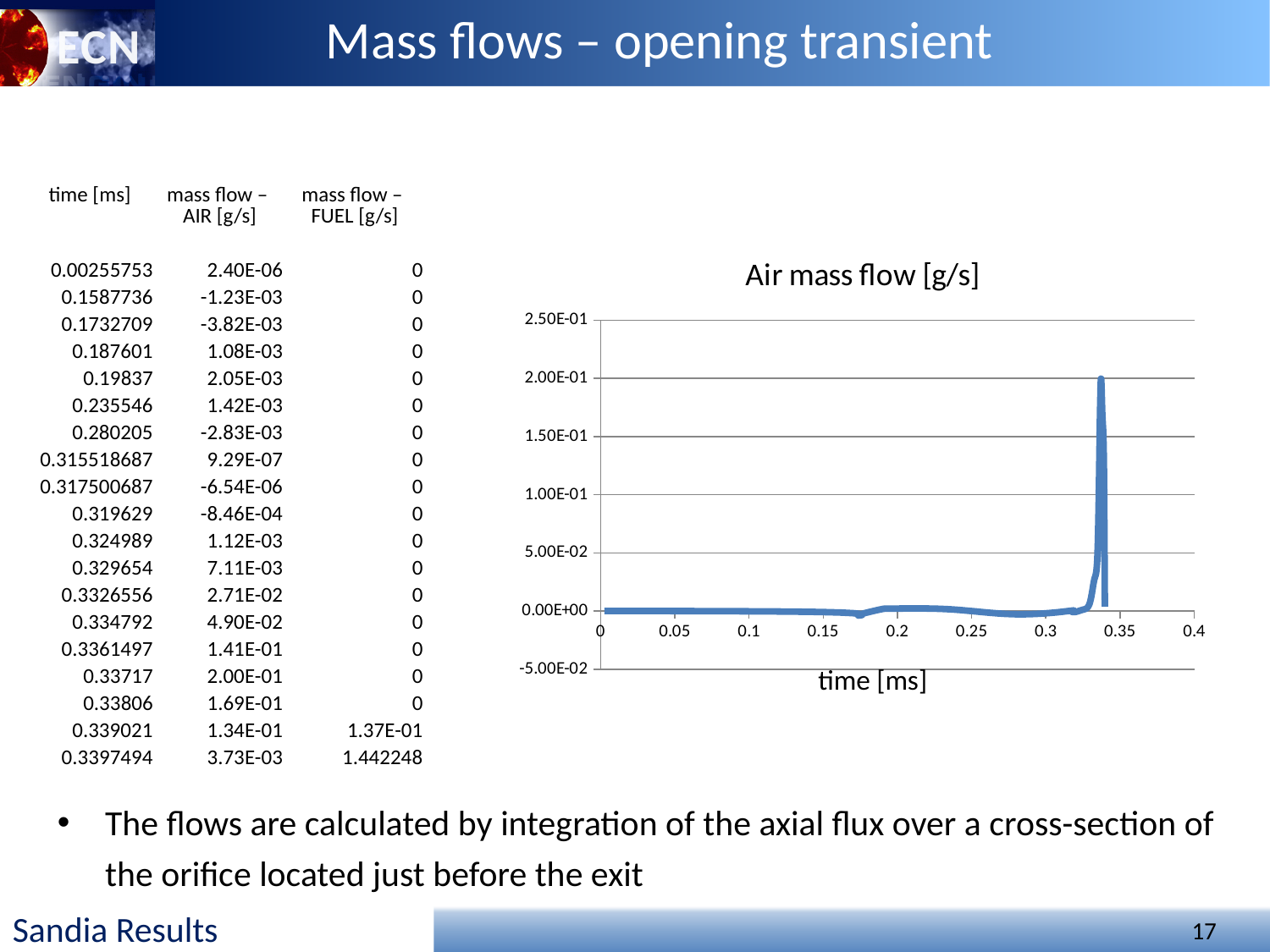
What is the label of the x axis of the chart? time [ms] What is the title of the chart? Air mass flow [g/s] How many data series are plotted in the chart? 1 Does the air mass flow rise or fall between 0.3 ms and about 0.34 ms? rises Is the air mass flow at time 0.05 ms greater or less than 1.00E-01? less What is the peak value of the air mass flow reached in the chart? 2.00E-01 Is the air mass flow at time 0.3 ms greater or less than 5.00E-02? less Is the air mass flow at time 0.1 ms greater or less than 5.00E-02? less What kind of chart is shown on the slide? line chart